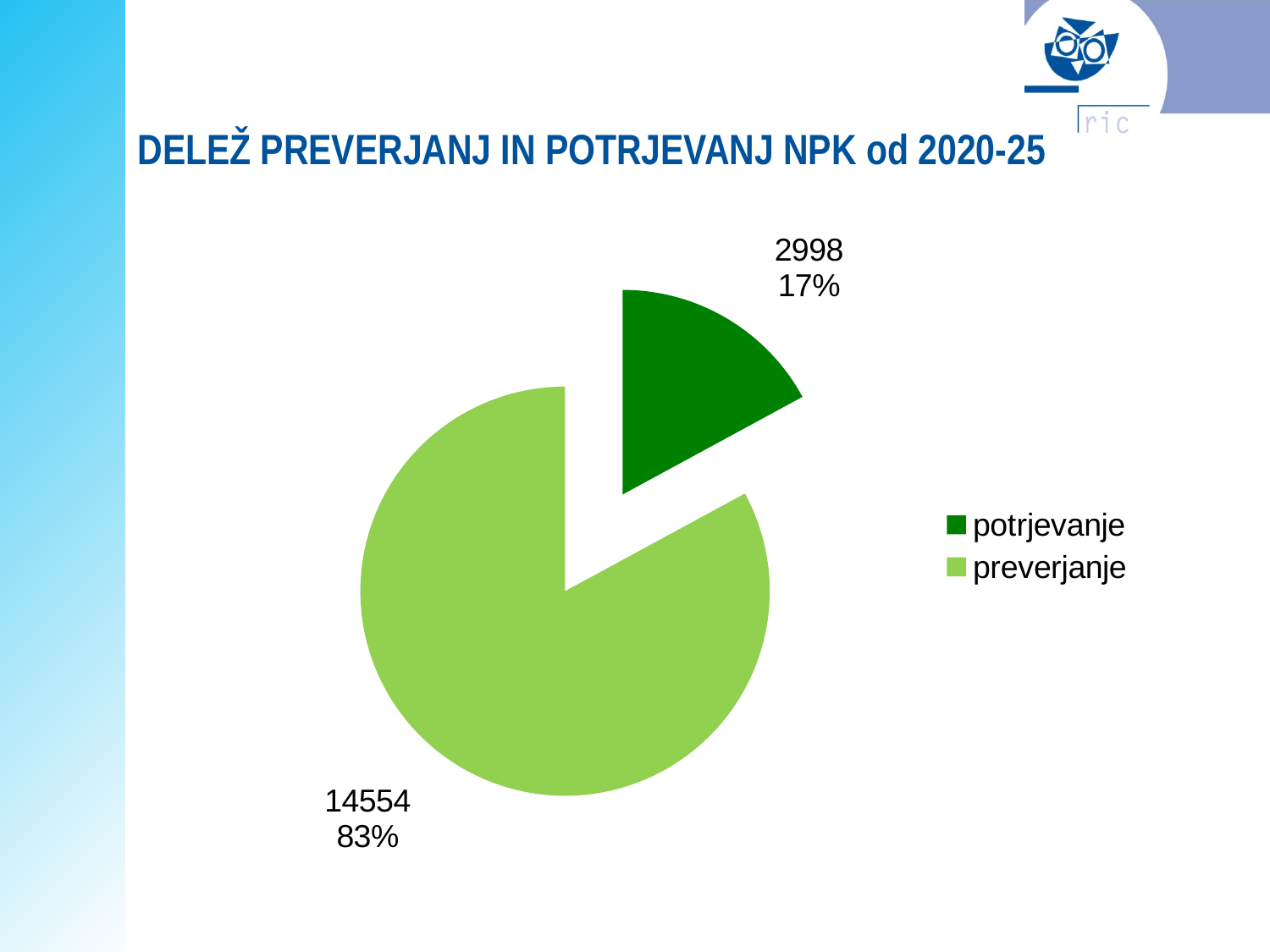
What is the value for potrjevanje? 2998 What is the total of the two values shown in the pie chart? 17552 What share of the pie does potrjevanje represent? 17% What is the difference between the values for preverjanje and potrjevanje? 11556 Which category has the smallest slice? potrjevanje What share of the pie does preverjanje represent? 83% What is the value for preverjanje? 14554 What kind of chart is shown on the slide? pie chart Which is larger, potrjevanje or preverjanje? preverjanje Which category has the largest slice? preverjanje What is the title of the slide containing the chart? DELEŽ PREVERJANJ IN POTRJEVANJ NPK od 2020-25 How many slices does the pie chart have? 2